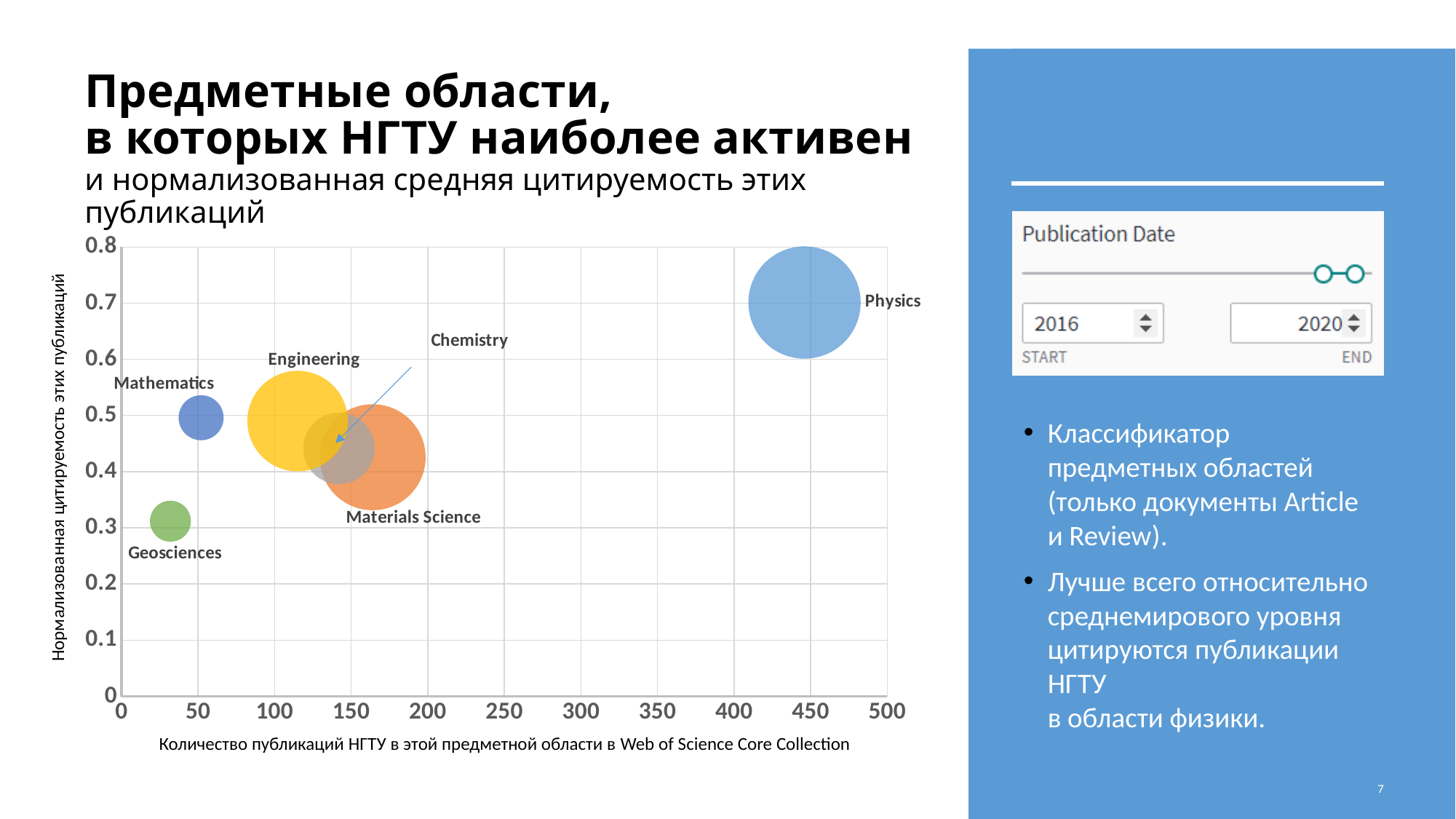
What kind of chart is shown on the slide? bubble chart Is the normalized citation value for Physics greater or less than 0.6? greater Is the number of publications for Physics greater or less than 400? greater How many subject areas (bubbles) are plotted on the chart? 6 Which subject area has the highest normalized citation value on the chart? Physics Which subject area has the lowest normalized citation value on the chart? Geosciences Which subject area has the largest number of publications (furthest right on the x axis)? Physics What does the x axis of the chart represent? Количество публикаций НГТУ в этой предметной области в Web of Science Core Collection Is the normalized citation value for Geosciences greater or less than 0.4? less Which has more publications, Materials Science or Geosciences? Materials Science Which has a higher normalized citation value, Physics or Materials Science? Physics